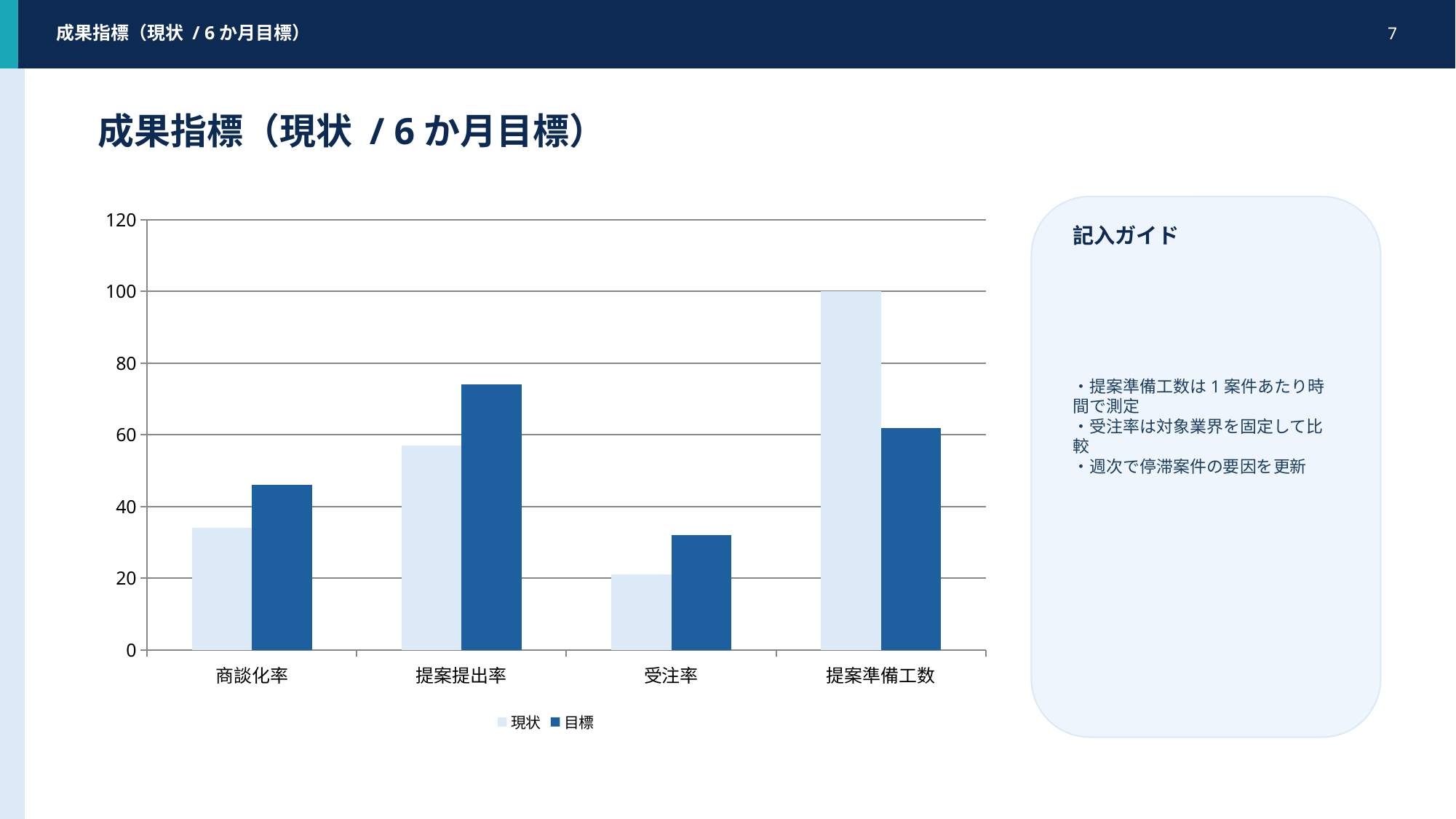
For 提案準備工数, which is larger, the 現状 value or the 目標 value? 現状 Which category has the lowest 現状 value? 受注率 Which category has the lowest 目標 value? 受注率 What is the 現状 value for 提案準備工数? 100 How many categories are shown on the x axis of the chart? 4 Is the 現状 value for 受注率 greater or less than 40? less Is the 目標 value for 提案提出率 greater or less than 60? greater What are the two series named in the chart legend? 現状 and 目標 What kind of chart is shown on the slide? bar chart How many series does the chart legend list? 2 Which category has the highest 現状 value? 提案準備工数 Which category has the highest 目標 value? 提案提出率